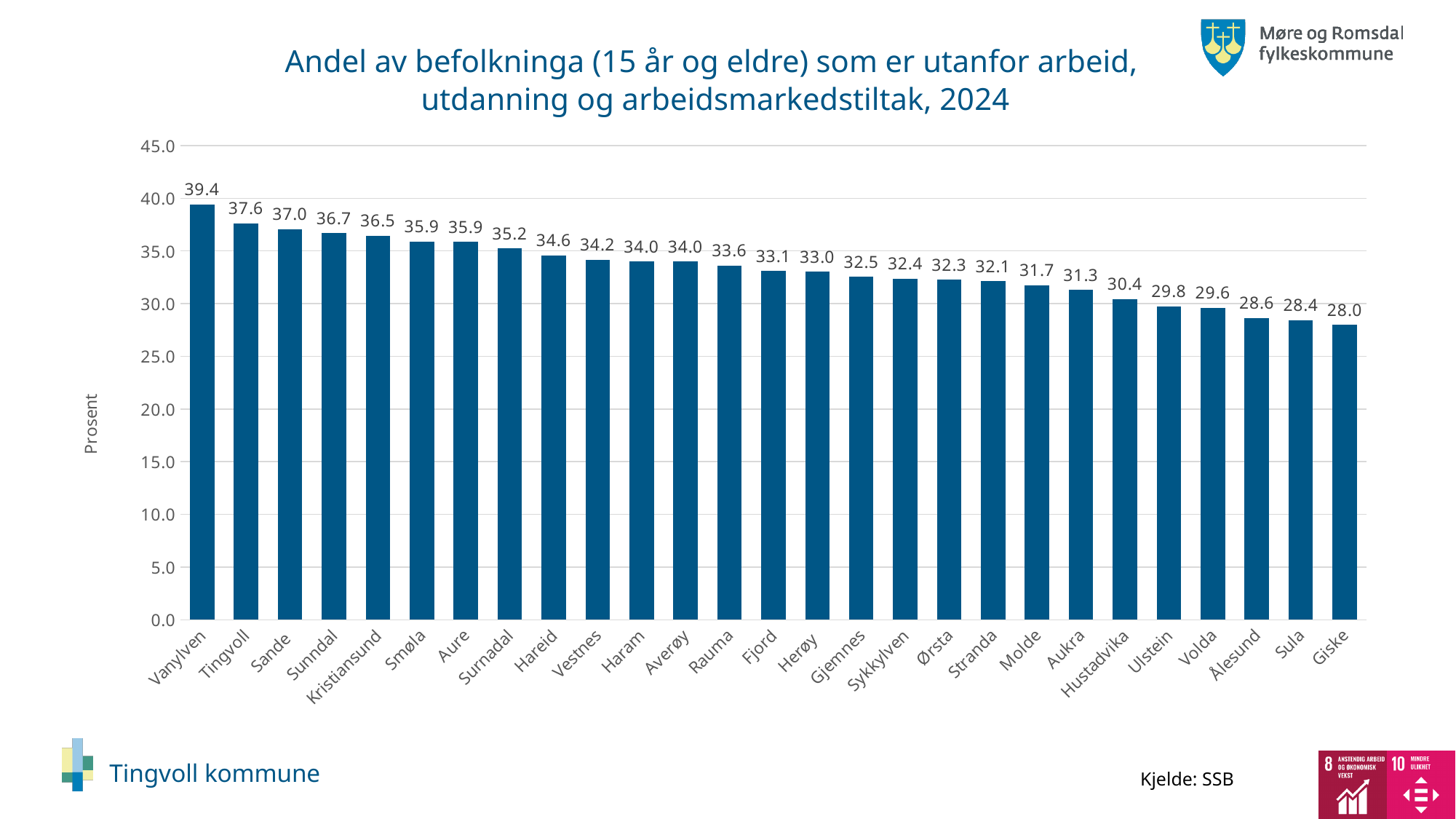
What kind of chart is shown on the slide? bar chart What is the label on the vertical axis? Prosent What is the value for Tingvoll? 37.6 What is the value for Molde? 31.7 How many municipalities are shown in the chart? 27 Which municipality has the highest value? Vanylven What is the value for Kristiansund? 36.5 Which municipality has the lowest value? Giske What is the difference between the values for Tingvoll and Ålesund? 9.0 What is the difference between the values for Vanylven and Giske? 11.4 Is the value for Hustadvika greater or less than 35.0? less Which is larger, the value for Sunndal or the value for Ulstein? Sunndal